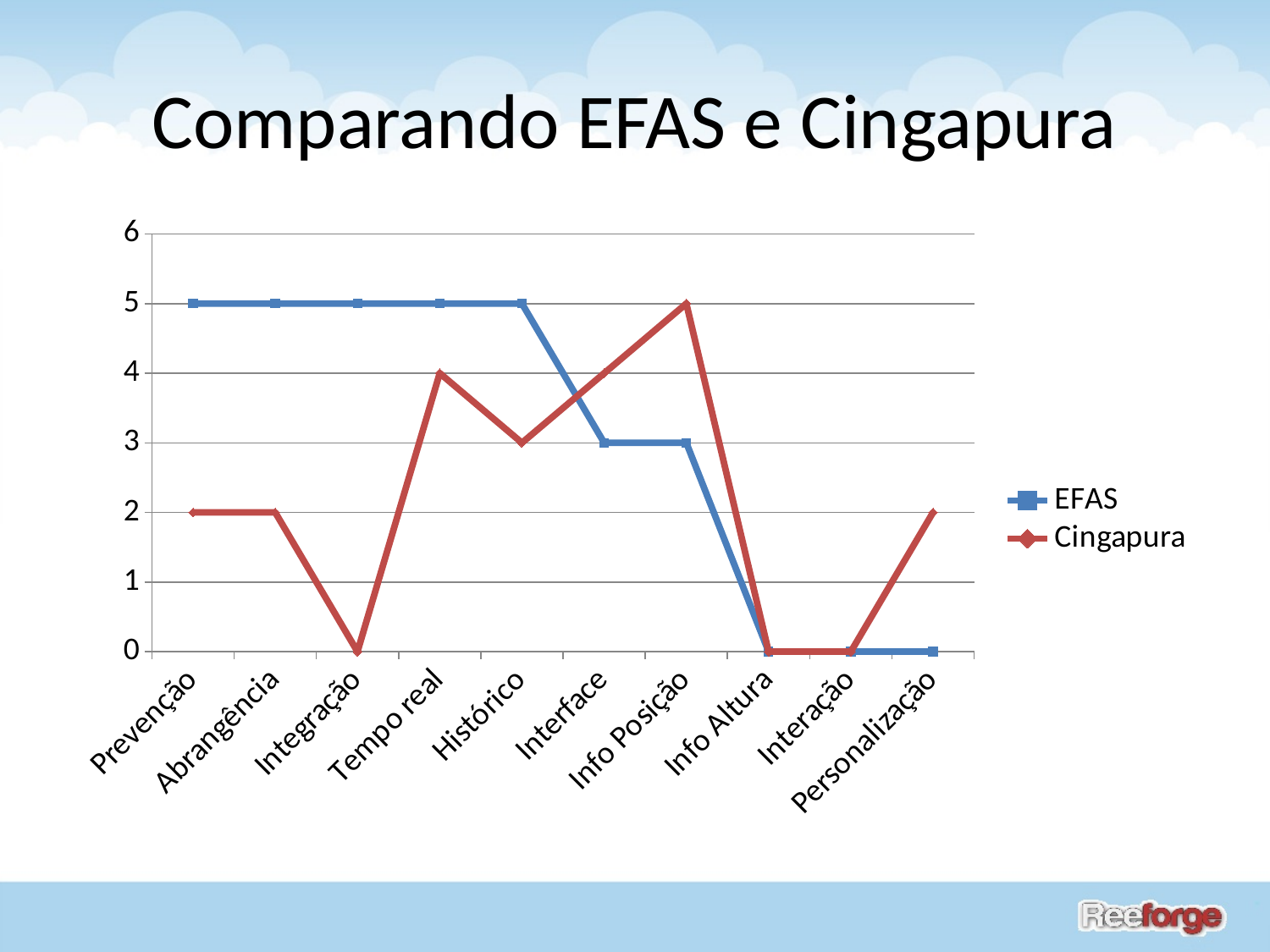
How many series does the legend list? 2 What is the value for Cingapura at Integração? 0 What is the value for EFAS at Prevenção? 5 At Histórico, which series has the higher value, EFAS or Cingapura? EFAS What is the difference between the EFAS and Cingapura values at Prevenção? 3 What is the value for Cingapura at Personalização? 2 At which category does Cingapura reach its highest value? Info Posição How many categories are shown on the x axis? 10 What is the value for EFAS at Interface? 3 Does the EFAS line generally rise or fall from left to right across the x axis? fall What is the value for Cingapura at Tempo real? 4 What kind of chart is shown on the slide? line chart